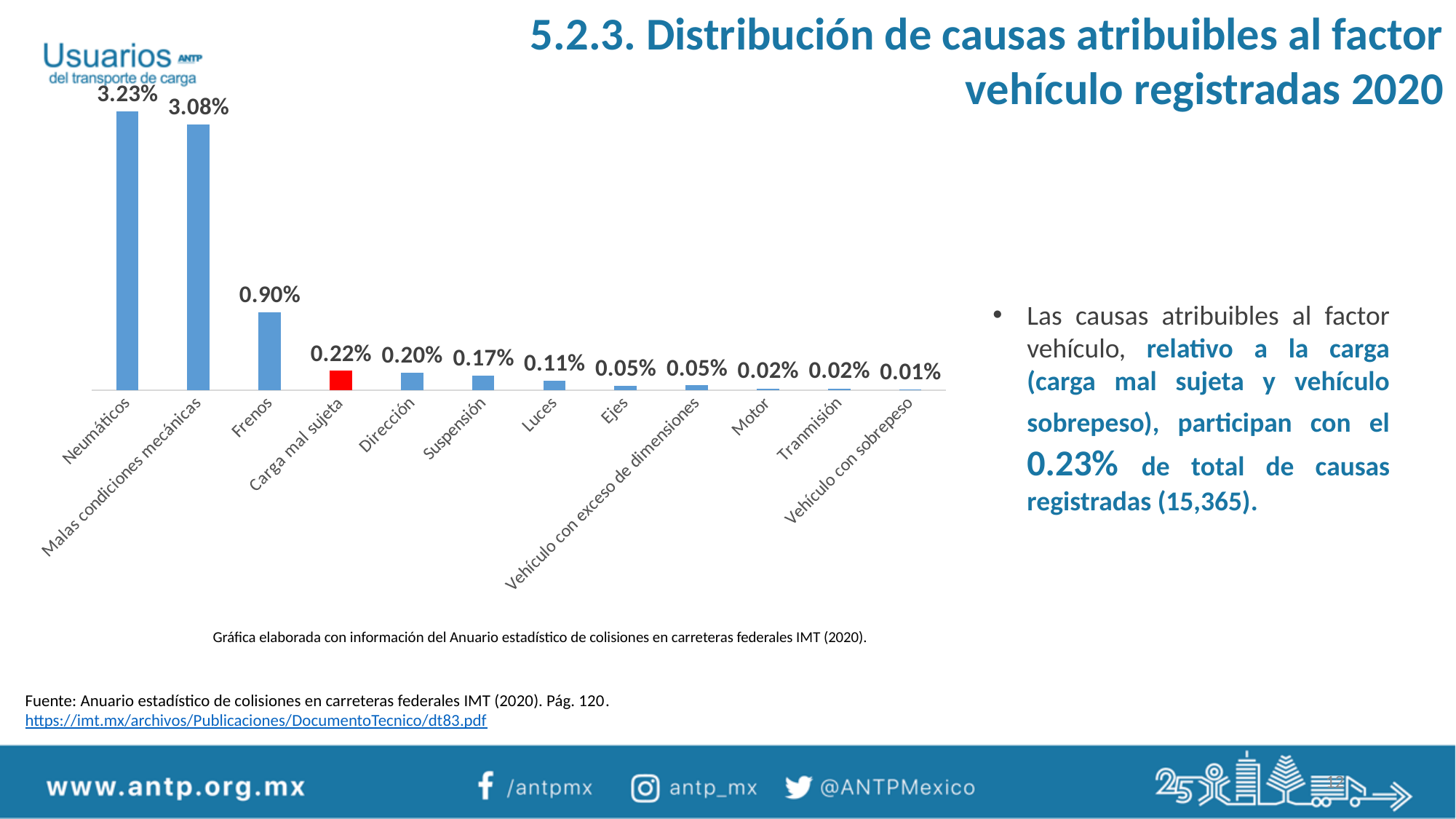
Do the values rise or fall from left to right along the x axis? Fall What is the value for Neumáticos? 3.23% Which category has the highest value? Neumáticos What is the value for Frenos? 0.90% What is the difference between the values for Neumáticos and Malas condiciones mecánicas? 0.15% What is the value for Carga mal sujeta? 0.22% Which is larger, the value for Dirección or the value for Suspensión? Dirección What kind of chart is shown on the slide? Bar chart Which category's bar is coloured red? Carga mal sujeta What is the value for Vehículo con sobrepeso? 0.01% How many categories are shown in the chart? 12 Which category has the lowest value? Vehículo con sobrepeso